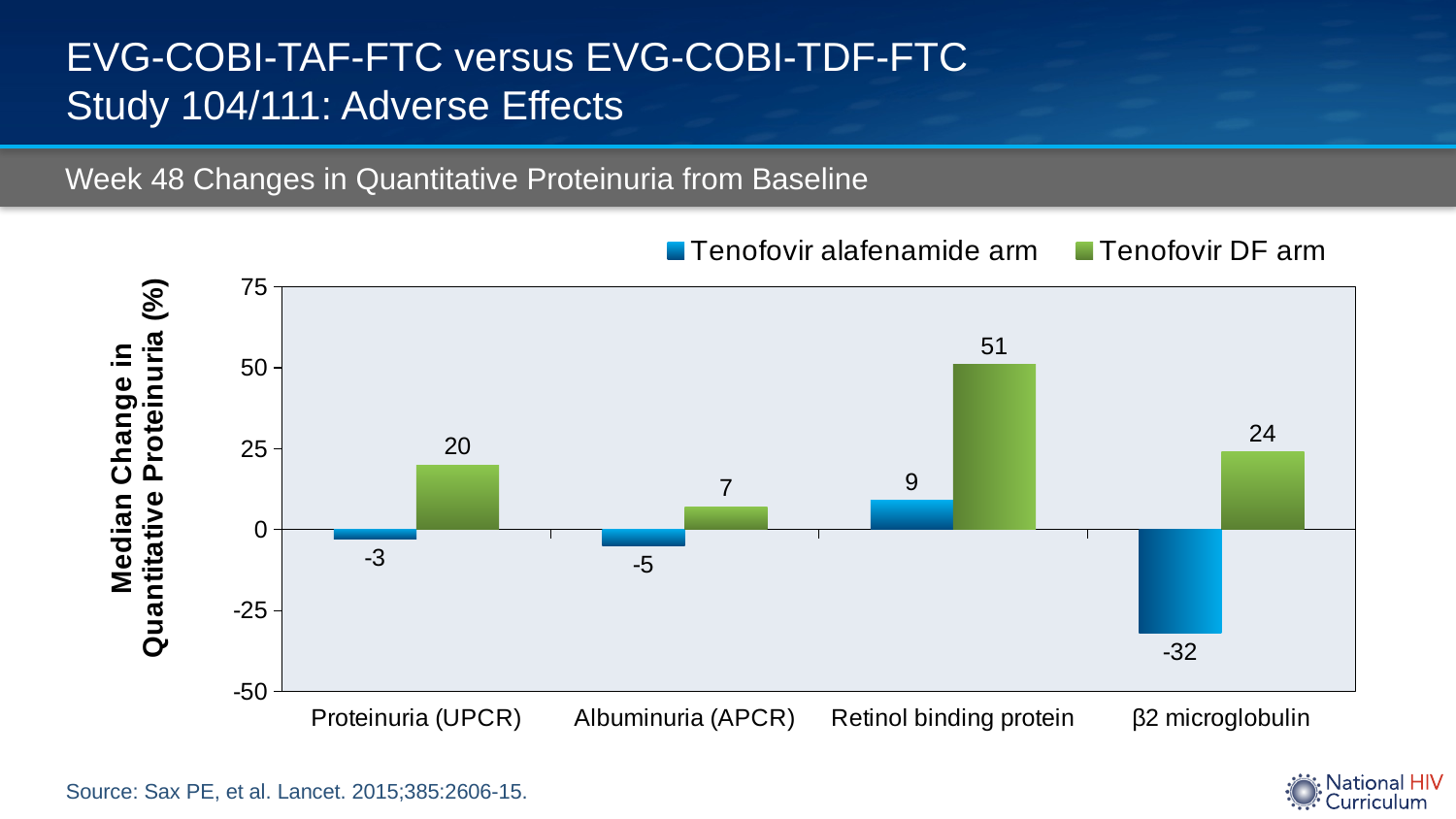
How many categories are shown on the x axis? 4 What is the difference between the Tenofovir DF arm and the Tenofovir alafenamide arm for Retinol binding protein? 42 How many series does the legend list? 2 What is the value for the Tenofovir alafenamide arm for β2 microglobulin? -32 What is the value for the Tenofovir alafenamide arm for Albuminuria (APCR)? -5 What is the value for the Tenofovir DF arm for Retinol binding protein? 51 What is the y-axis label of the chart? Median Change in Quantitative Proteinuria (%) What is the value for the Tenofovir DF arm for Proteinuria (UPCR)? 20 Which category has the lowest value for the Tenofovir alafenamide arm? β2 microglobulin What kind of chart is shown on the slide? Bar chart Which category has the highest value for the Tenofovir DF arm? Retinol binding protein Which is larger for Albuminuria (APCR): the Tenofovir alafenamide arm or the Tenofovir DF arm? Tenofovir DF arm